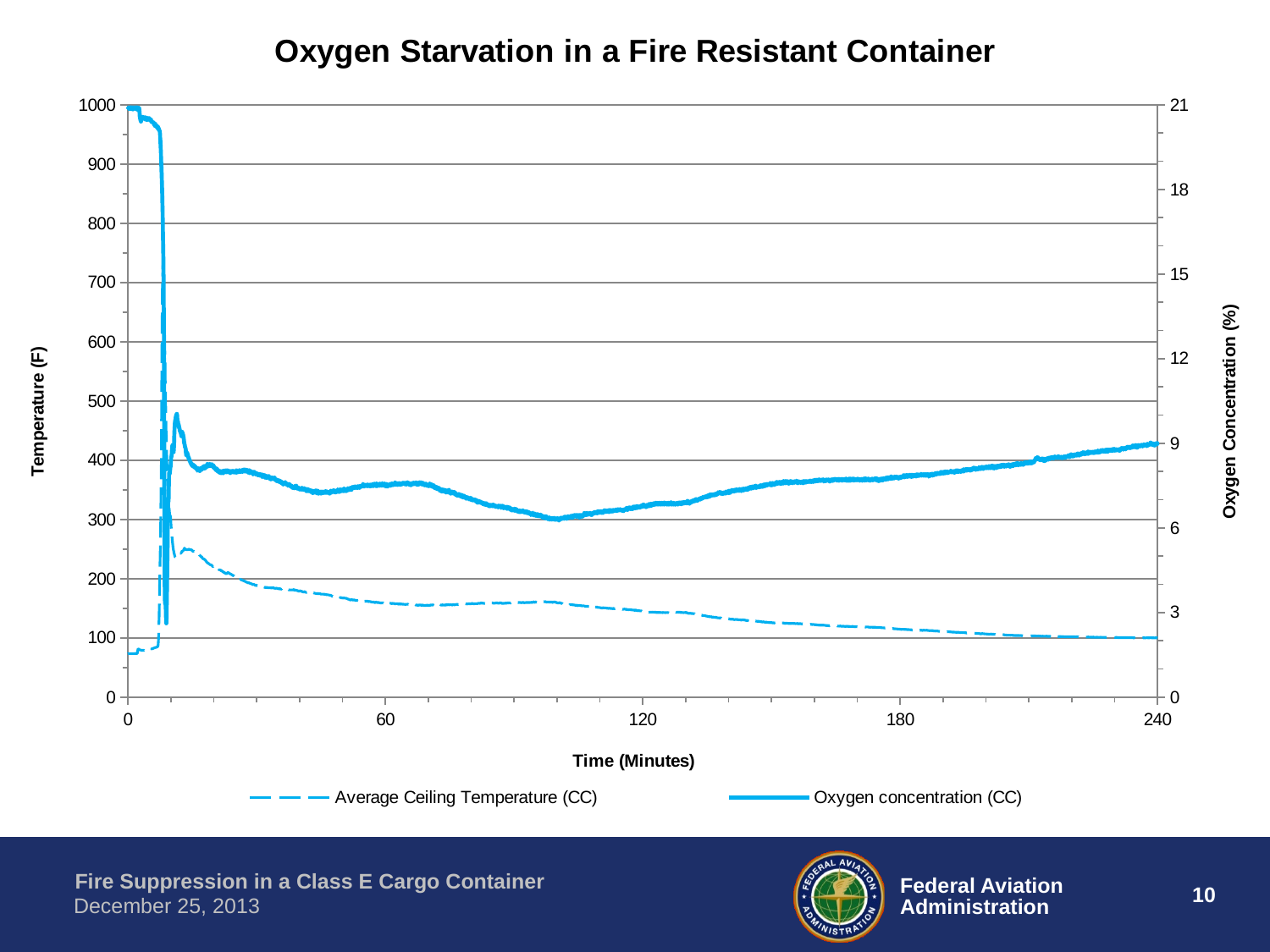
Does the Average Ceiling Temperature (CC) series rise or fall between 60 and 240 minutes? fall Is the Oxygen concentration (CC) value at 60 minutes greater or less than 6? greater What is the title of the chart? Oxygen Starvation in a Fire Resistant Container What kind of chart is shown on the slide? line chart Is the Average Ceiling Temperature (CC) value at 240 minutes greater or less than 200? less Is the Oxygen concentration (CC) value at 240 minutes greater or less than 6? greater How many series does the legend list? 2 What is the label of the x axis? Time (Minutes) Does the Oxygen concentration (CC) series rise or fall between 120 and 240 minutes? rise